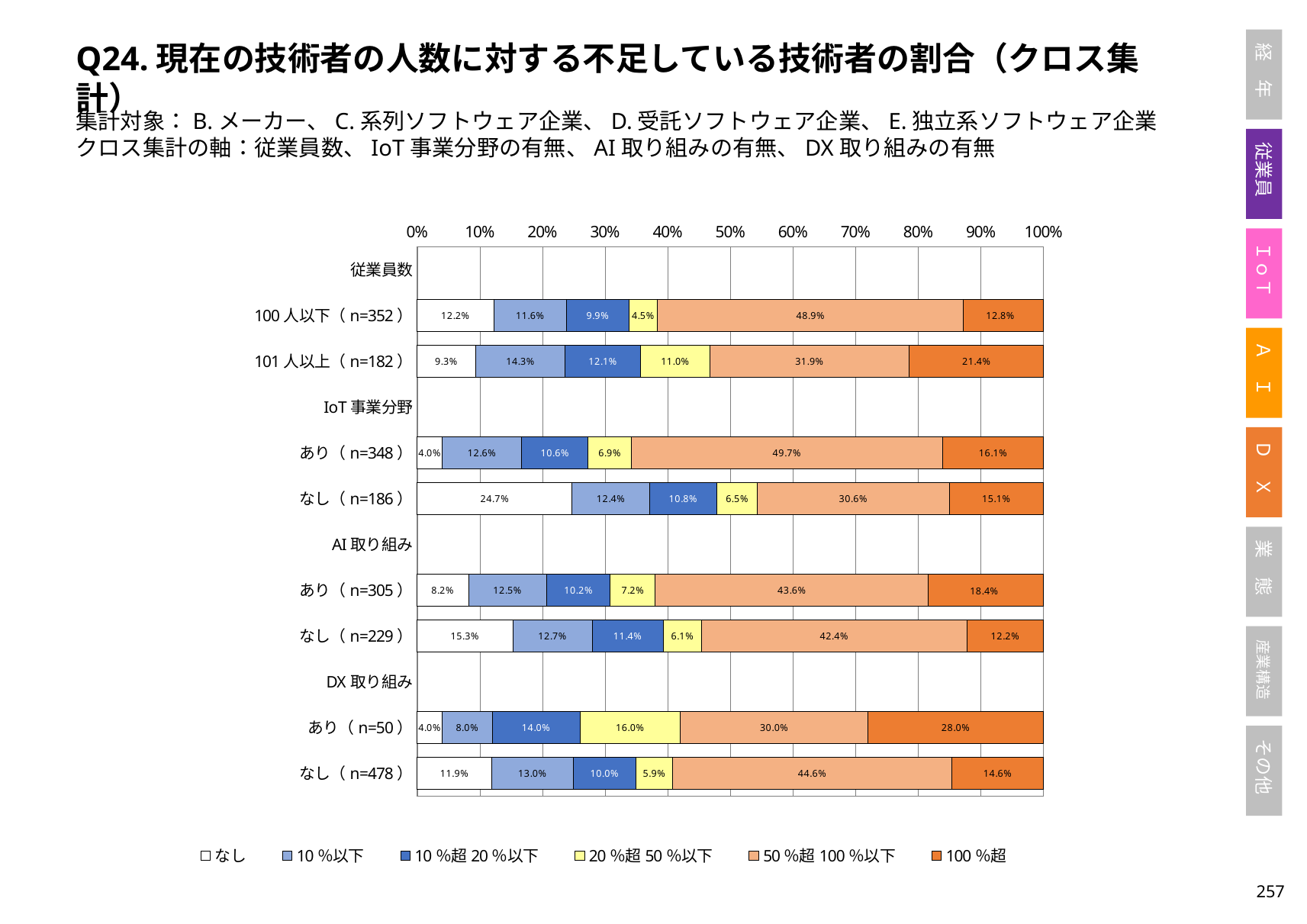
What type of chart is shown on the slide? Stacked bar chart What is the value of the 50%超100%以下 segment for 100人以下 (n=352)? 48.9% How many bars with data are plotted in the chart? 8 How many series does the legend list? 6 What is the value of the 100%超 segment for DX取り組み あり (n=50)? 28.0% What is the value of the 50%超100%以下 segment for IoT事業分野 あり (n=348)? 49.7% What is the value of the 100%超 segment for 101人以上 (n=182)? 21.4% Which has the larger 20%超50%以下 segment: DX取り組み あり (n=50) or DX取り組み なし (n=478)? DX取り組み あり (n=50) What is the difference between the 100%超 values for 101人以上 (n=182) and 100人以下 (n=352)? 8.6 percentage points Which bar has the largest なし segment? IoT事業分野 なし (n=186) What is the value of the なし segment for IoT事業分野 なし (n=186)? 24.7% Which bar has the largest 100%超 segment? DX取り組み あり (n=50)